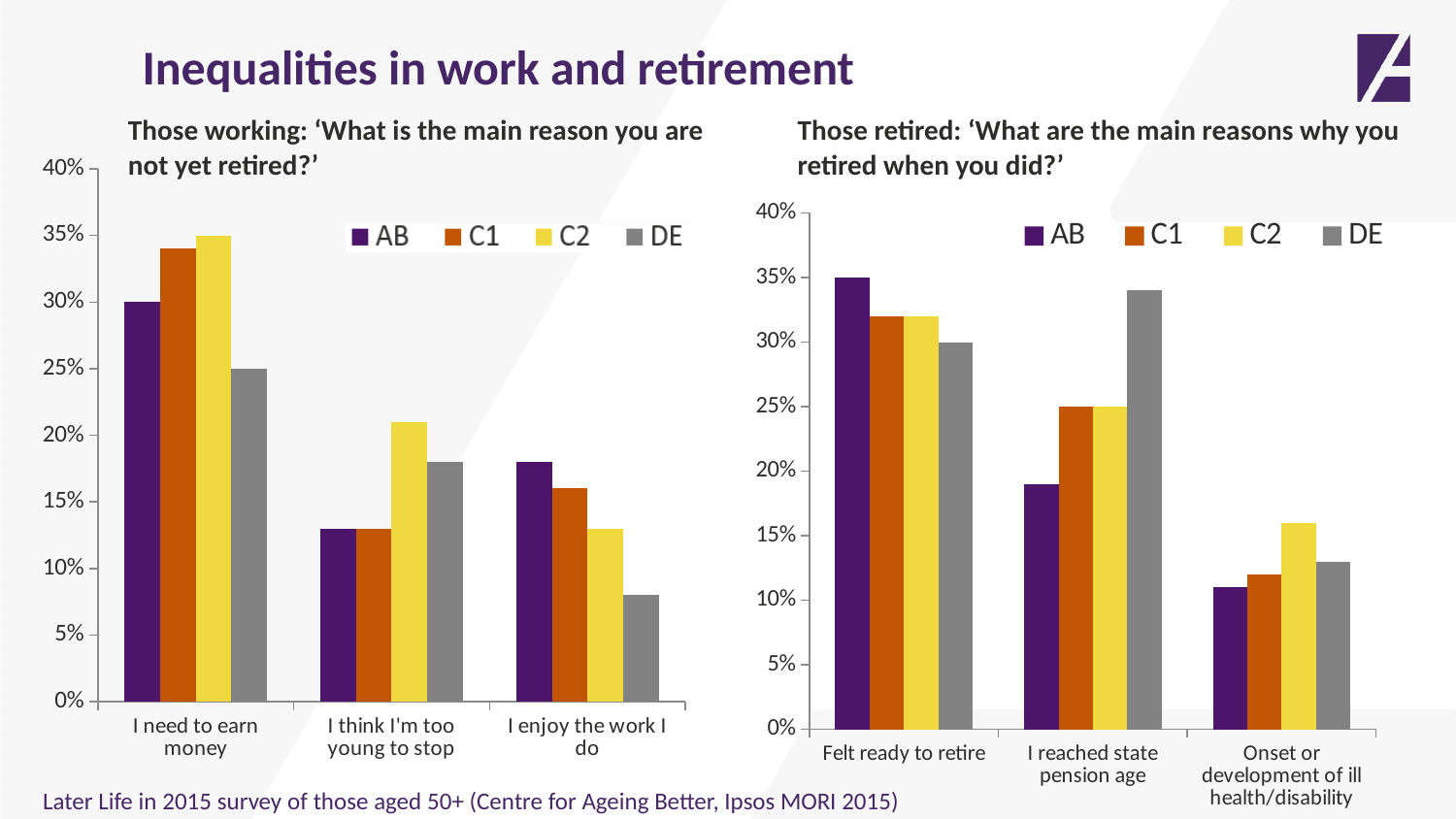
In the left chart ('Those working'), which series has the lowest value for 'I enjoy the work I do'? DE In the left chart ('Those working'), is the value for DE in 'I enjoy the work I do' greater or less than 10%? less In the left chart ('Those working'), is the value for C2 in 'I think I'm too young to stop' greater or less than 20%? greater In the left chart ('Those working'), how many series does the legend list? 4 In the right chart ('Those retired'), which series has the highest value for 'I reached state pension age'? DE In the left chart ('Those working'), which series has the highest value for 'I need to earn money'? C2 In the right chart ('Those retired'), how many categories are shown on the x axis? 3 What type of chart is shown on the left of the slide? bar chart In the left chart ('Those working'), which colour represents the C1 series? orange In the right chart ('Those retired'), which is larger for 'I reached state pension age': AB or DE? DE In the right chart ('Those retired'), is the value for C2 in 'Onset or development of ill health/disability' greater or less than 15%? greater In the right chart ('Those retired'), which series has the highest value for 'Felt ready to retire'? AB